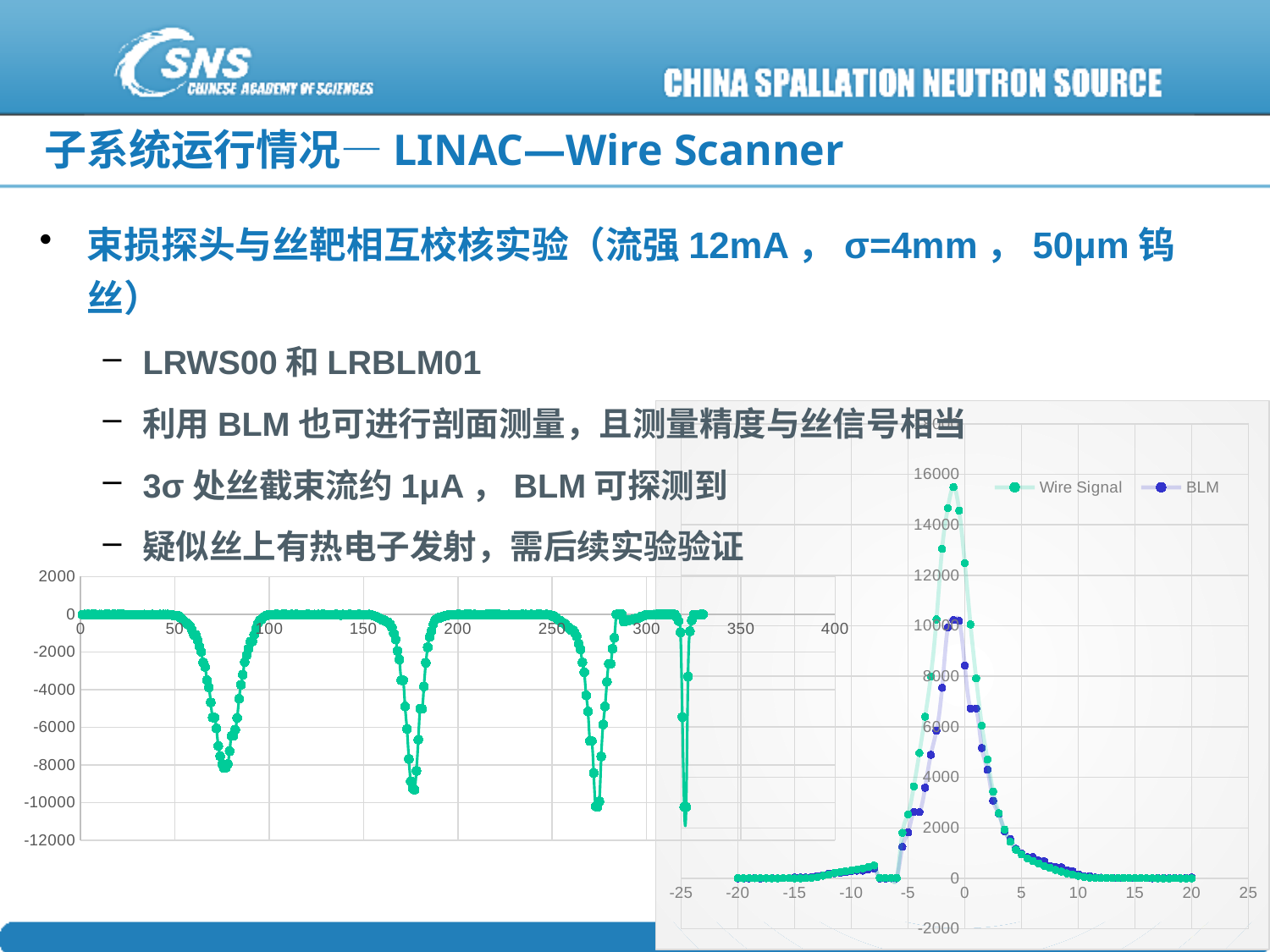
In the left chart, what is the maximum value shown on the x axis? 400 How many charts are shown on the slide? 2 In the right chart, is the peak value of the BLM series greater or less than 12000? less In the right chart, which series reaches the higher peak value? Wire Signal In the right chart, what is the highest value shown on the y axis? 18000 In the right chart, what are the names of the two series in the legend? Wire Signal and BLM In the left chart, how many large downward dips does the signal show? 4 In the right chart, is the peak value of the Wire Signal series greater or less than 14000? greater What kind of chart is the right chart with the Wire Signal and BLM series? line chart In the right chart, how many series does the legend list? 2 In the left chart, is the depth of the first dip (near x = 75) greater or less than -6000? less